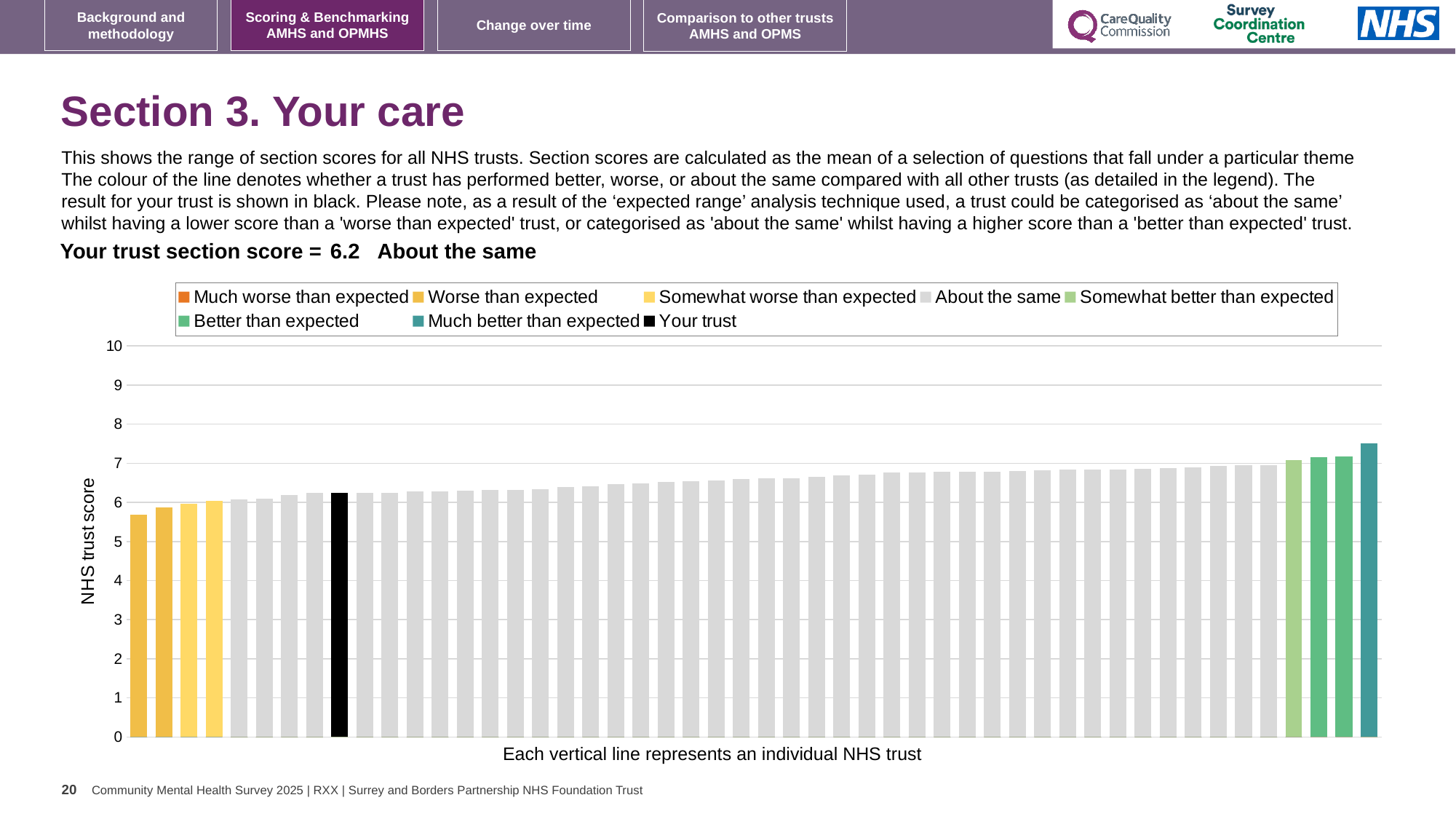
Which legend category does the tallest bar in the chart belong to? Much better than expected Is the value of the black bar (your trust) greater or less than 5? greater What is the section score for your trust shown on the slide? 6.2 Which legend category does the shortest bar in the chart belong to? Worse than expected Which legend category does your trust fall into for Section 3. Your care? About the same Is the value of the leftmost (lowest) bar greater or less than 6? less What is the label on the vertical axis of the chart? NHS trust score Do the bar values rise or fall from left to right along the x axis? rise Is the value of the rightmost (highest) bar greater or less than 7? greater What kind of chart is shown on the slide? bar chart How many entries does the chart legend list? 8 Which is larger: the black bar for your trust or the leftmost bar? the black bar for your trust